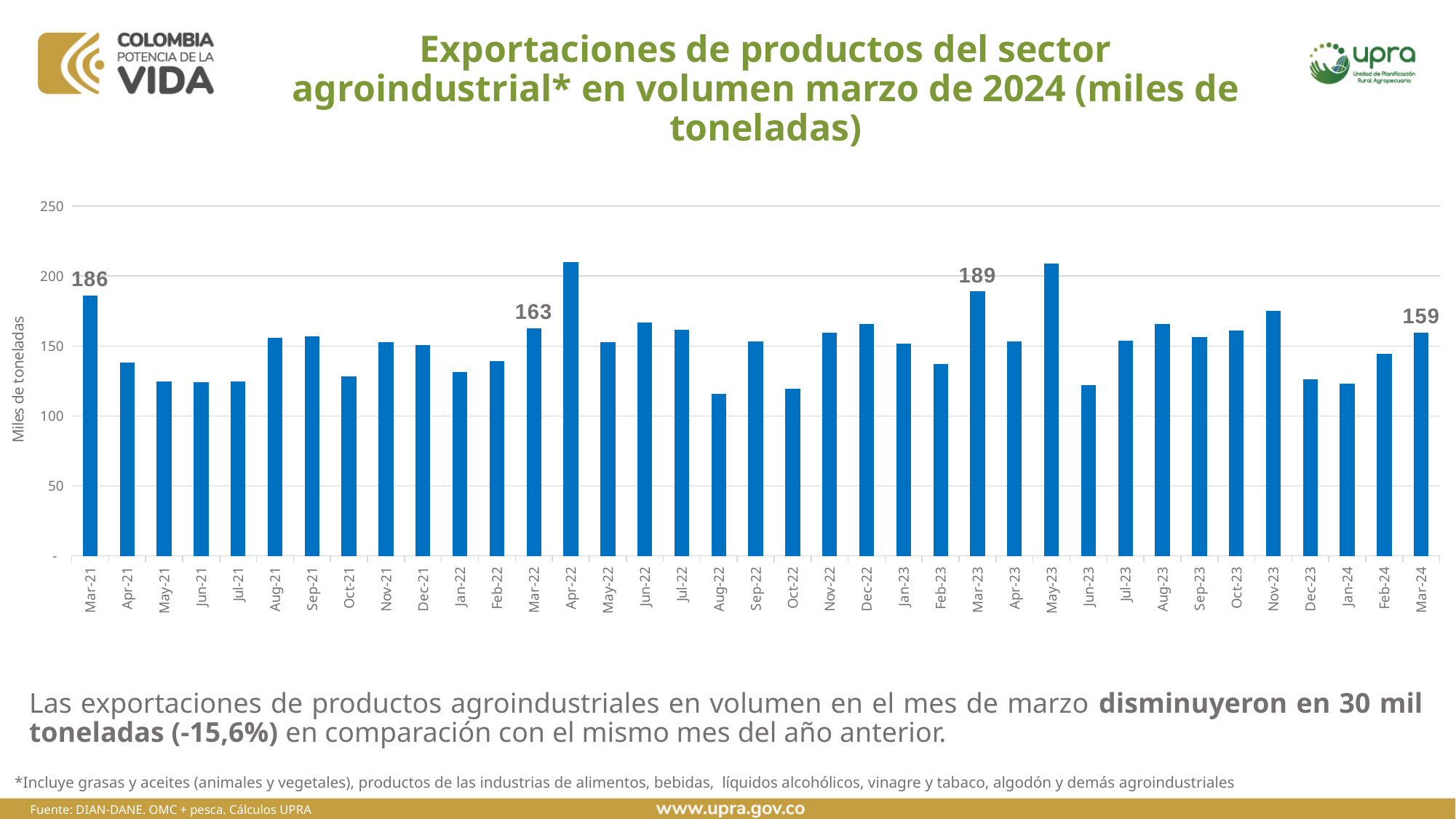
How many months are plotted on the x axis? 37 What is the difference between the values for Mar-21 and Mar-22? 23 What is the label of the vertical axis? Miles de toneladas What is the value for Mar-21? 186 Is the value for Apr-22 greater or less than 200? greater What is the value for Mar-22? 163 What is the value for Mar-24? 159 What is the value for Mar-23? 189 What kind of chart is shown on the slide? bar chart What is the difference between the values for Mar-23 and Mar-24? 30 Which is larger, the value for Mar-23 or the value for Mar-22? Mar-23 Is the value for Aug-22 greater or less than 150? less